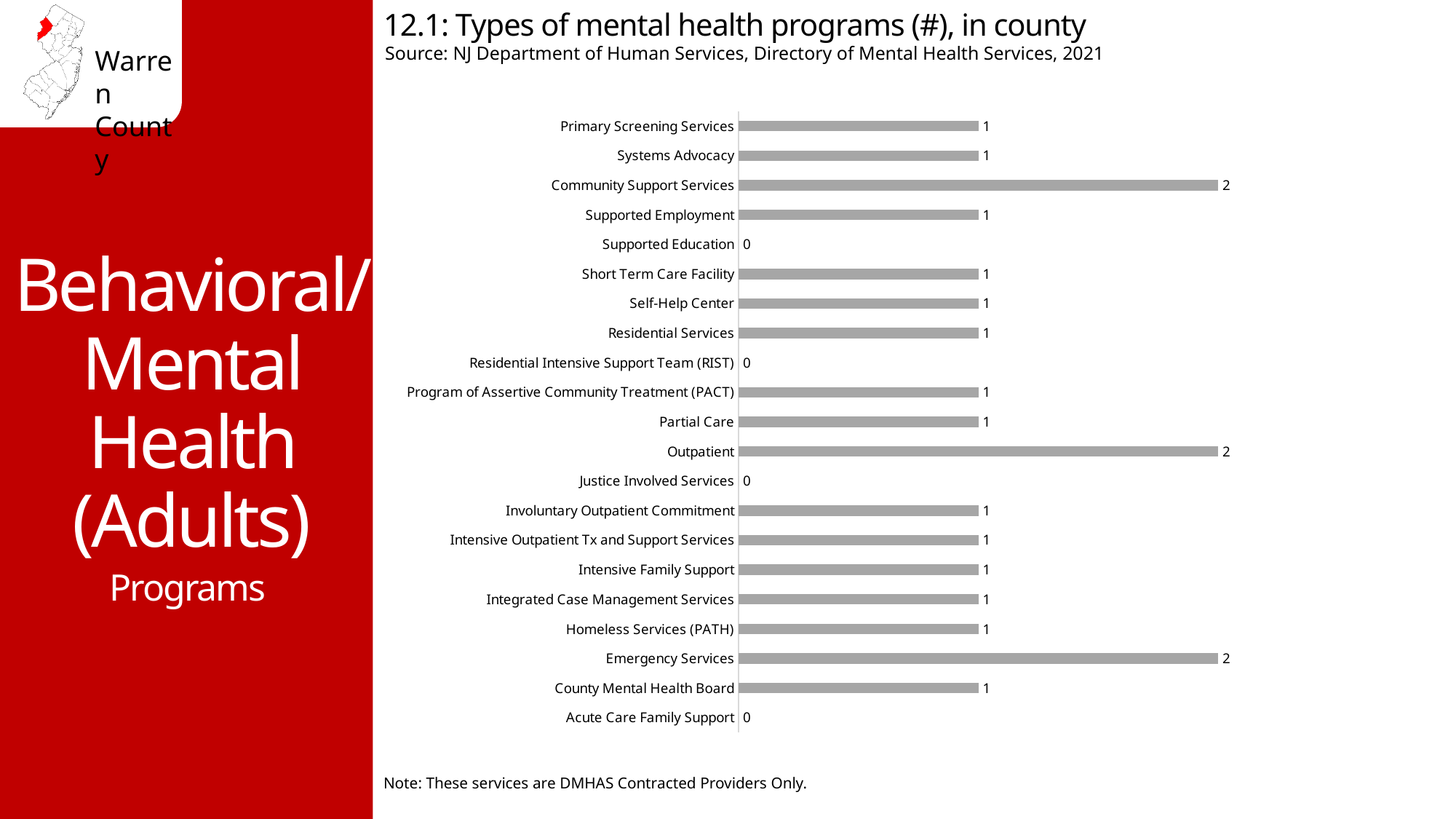
What is the value for Supported Education? 0 What is the value for Homeless Services (PATH)? 1 Which is larger, the value for Self-Help Center or the value for Justice Involved Services? Self-Help Center What is the value for Emergency Services? 2 Which is larger, the value for Emergency Services or the value for County Mental Health Board? Emergency Services How many categories have a value of 2? 3 What is the difference between the values for Outpatient and Partial Care? 1 What is the value for Community Support Services? 2 What is the value for Residential Intensive Support Team (RIST)? 0 What is the title of the chart? 12.1: Types of mental health programs (#), in county How many categories are shown on the chart? 21 What kind of chart is shown on the slide? Bar chart